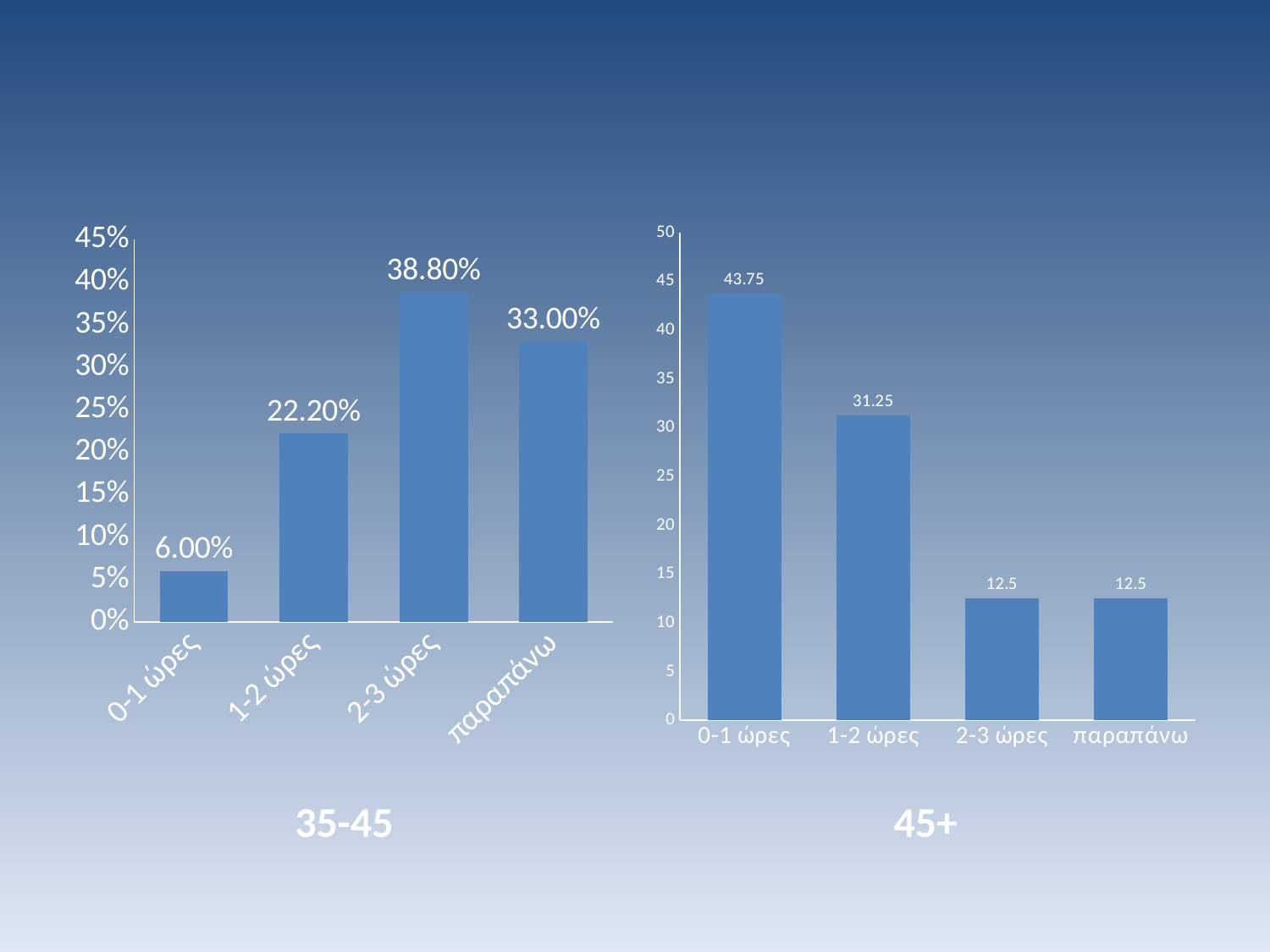
In the 35-45 chart, which is larger: the value for 2-3 ώρες or the value for παραπάνω? 2-3 ώρες In the 45+ chart, what is the value for 1-2 ώρες? 31.25 In the 45+ chart, which category has the highest value? 0-1 ώρες In the 35-45 chart, what is the value for 0-1 ώρες? 6.00% In the 45+ chart, do the values rise or fall from 0-1 ώρες to 2-3 ώρες? fall In the 45+ chart, what is the difference between the values for 0-1 ώρες and παραπάνω? 31.25 In the 35-45 chart, which category has the lowest value? 0-1 ώρες In the 45+ chart, is the value for 1-2 ώρες greater or less than 30? greater What kind of chart is the 35-45 chart? bar chart How many categories are shown in the 45+ chart? 4 In the 35-45 chart, what is the difference between the values for 2-3 ώρες and 1-2 ώρες? 16.60% In the 35-45 chart, what is the value for 2-3 ώρες? 38.80%